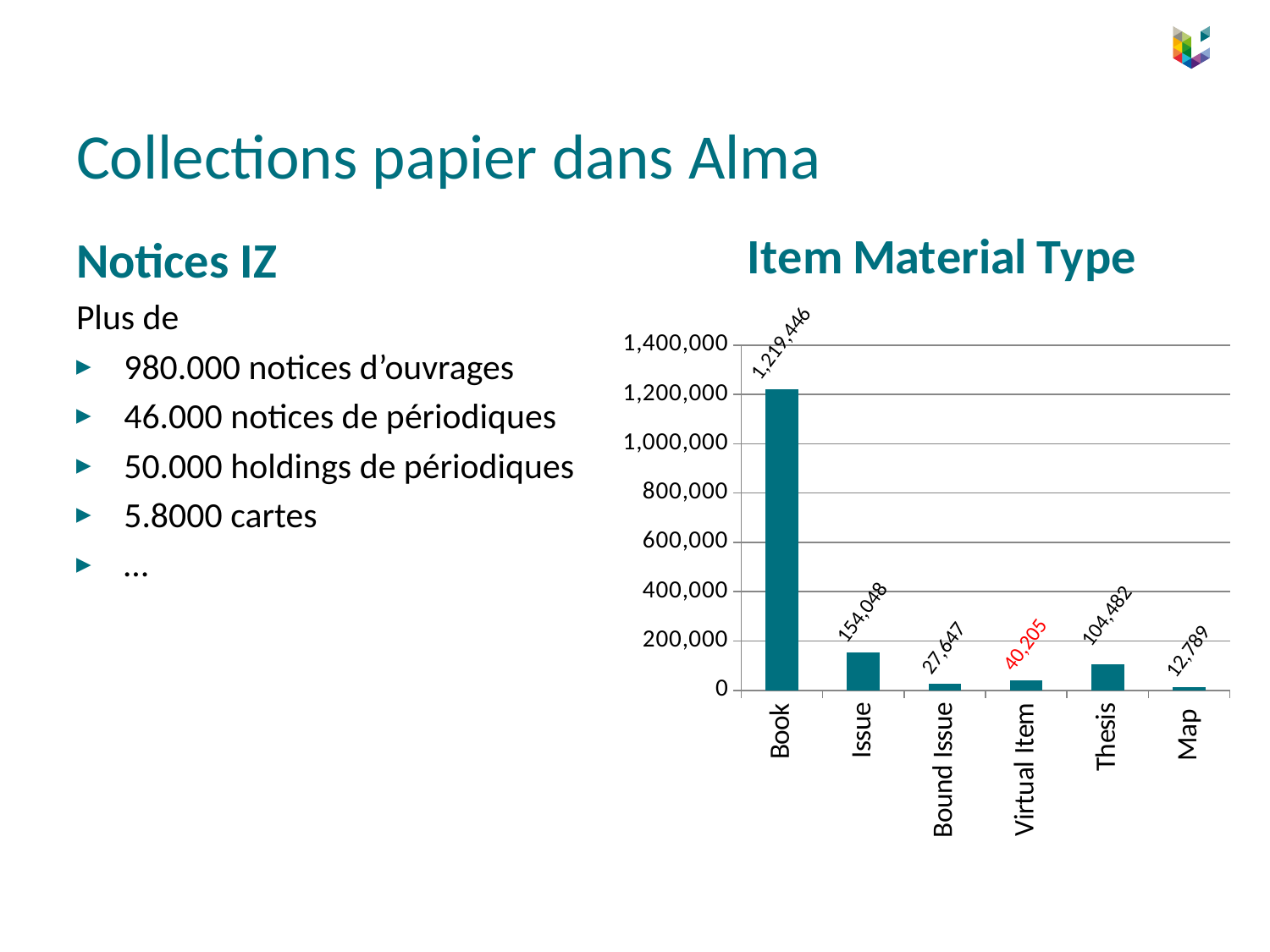
Which category has the lowest value in the Item Material Type chart? Map What kind of chart is the Item Material Type chart? bar chart Which data label in the Item Material Type chart is shown in red? 40,205 (Virtual Item) Is the value for Book in the Item Material Type chart greater or less than 1,000,000? greater How many categories are shown in the Item Material Type chart? 6 What is the value for Map in the Item Material Type chart? 12,789 What is the value for Issue in the Item Material Type chart? 154,048 Which category has the highest value in the Item Material Type chart? Book What is the difference between the values for Issue and Thesis in the Item Material Type chart? 49,566 Which is larger in the Item Material Type chart, Bound Issue or Virtual Item? Virtual Item What is the value for Book in the Item Material Type chart? 1,219,446 What is the value for Virtual Item in the Item Material Type chart? 40,205